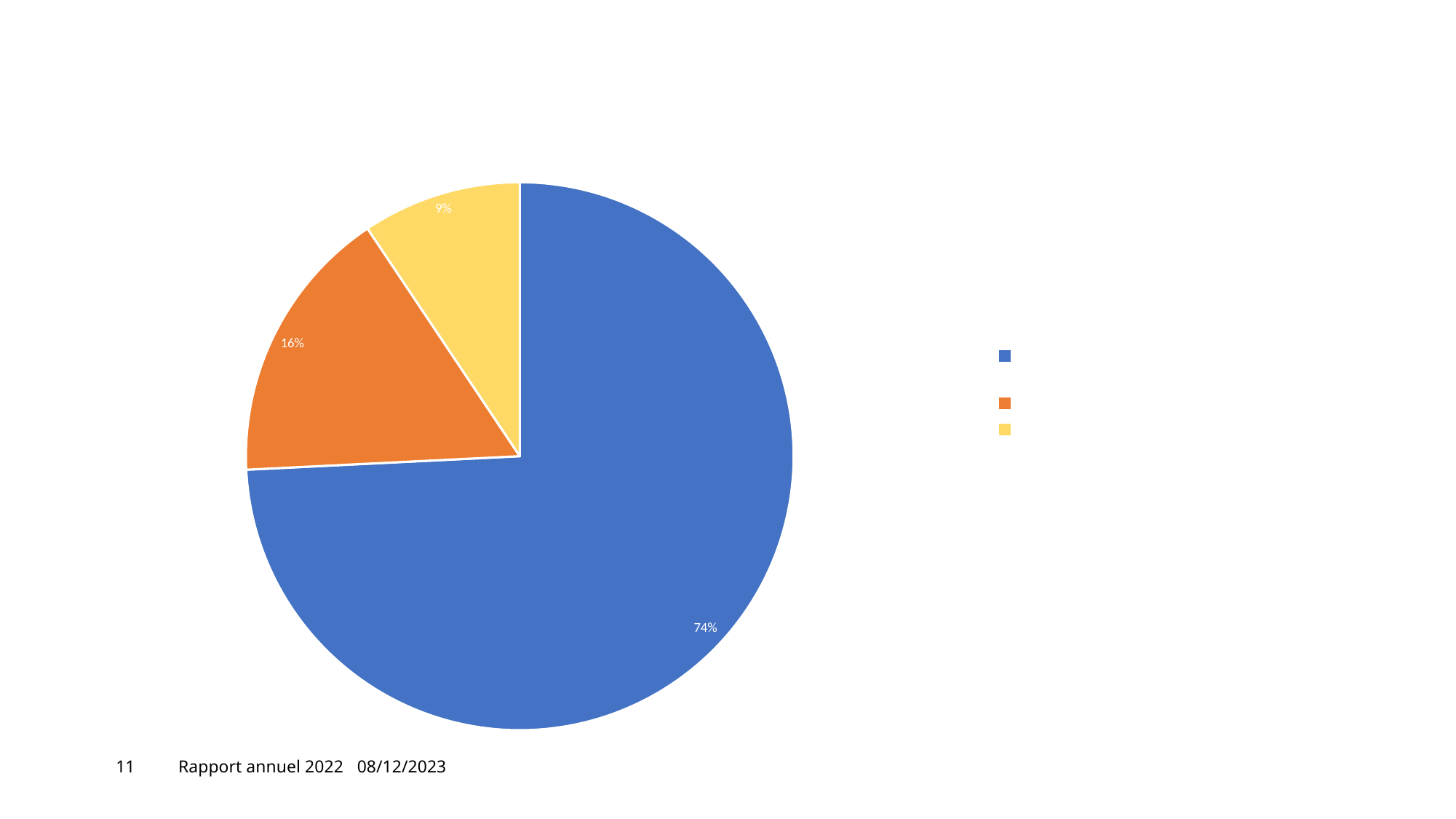
What kind of chart is shown on the slide? pie chart What is the difference in percentage points between the orange slice and the yellow slice? 7 What is the difference in percentage points between the blue slice and the orange slice? 58 Which is larger, the orange slice or the yellow slice? orange Which colour slice is the smallest in the pie chart? yellow What percentage is shown on the orange slice of the pie chart? 16% What colour is the first entry in the legend of the pie chart? blue What percentage is shown on the blue slice of the pie chart? 74% How many entries does the legend of the pie chart list? 3 Which colour slice is the largest in the pie chart? blue How many slices does the pie chart have? 3 What percentage is shown on the yellow slice of the pie chart? 9%